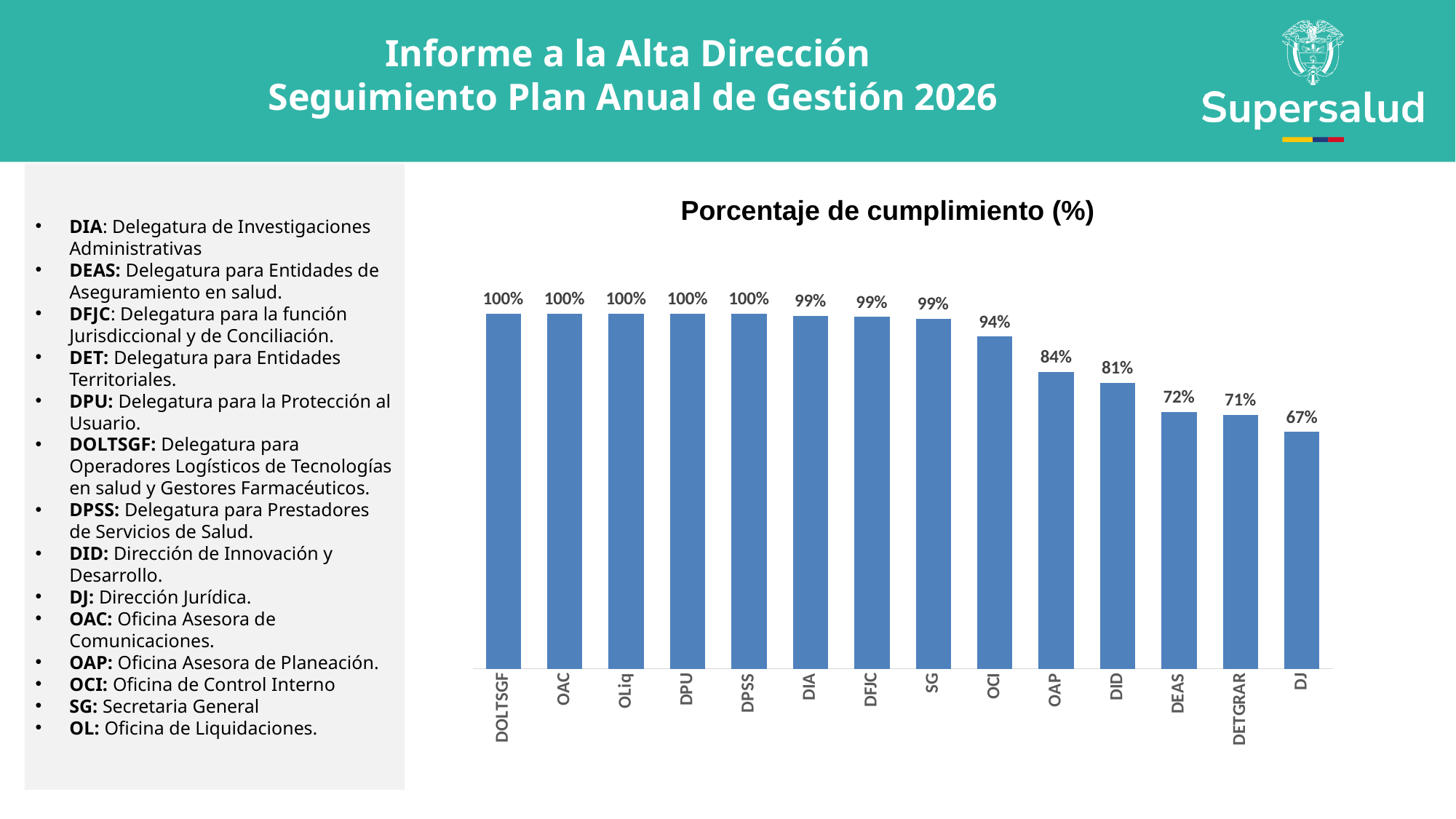
Which is larger, the value for DID or the value for DETGRAR? DID How many categories are shown in the chart? 14 What kind of chart is shown on the slide? Bar chart What is the value for DIA in the chart? 99% What is the difference between the values for OAP and DID? 3% What is the value for OCI in the chart? 94% Which category has the lowest value in the chart? DJ What is the difference between the values for OCI and DJ? 27% What is the value for DJ in the chart? 67% What is the title of the chart? Porcentaje de cumplimiento (%) What is the value for DEAS in the chart? 72% What is the value for OAP in the chart? 84%